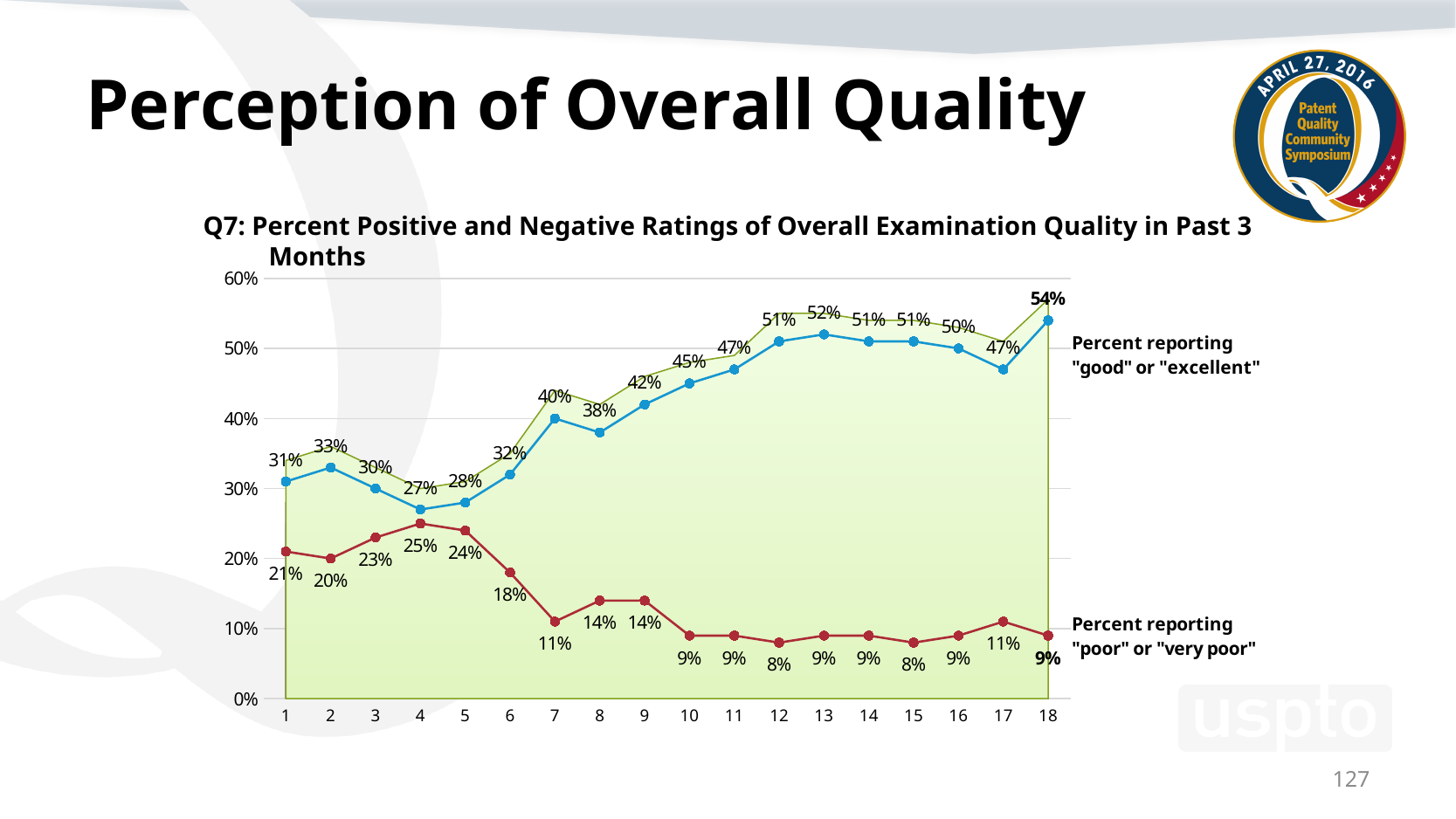
What is the percent reporting "good" or "excellent" at point 18? 54% Does the percent reporting "poor" or "very poor" generally rise or fall from point 1 to point 18? Fall How many points are plotted along the x axis? 18 What is the percent reporting "poor" or "very poor" at point 4? 25% Which is larger at point 1: the percent reporting "good" or "excellent" or the percent reporting "poor" or "very poor"? Percent reporting "good" or "excellent" At which point is the percent reporting "poor" or "very poor" the highest? 4 What is the percent reporting "good" or "excellent" at point 7? 40% What kind of chart is shown on the slide? Line chart What is the difference between the "good" or "excellent" percentage and the "poor" or "very poor" percentage at point 18? 45% At which point is the percent reporting "good" or "excellent" the lowest? 4 At which point is the percent reporting "good" or "excellent" the highest? 18